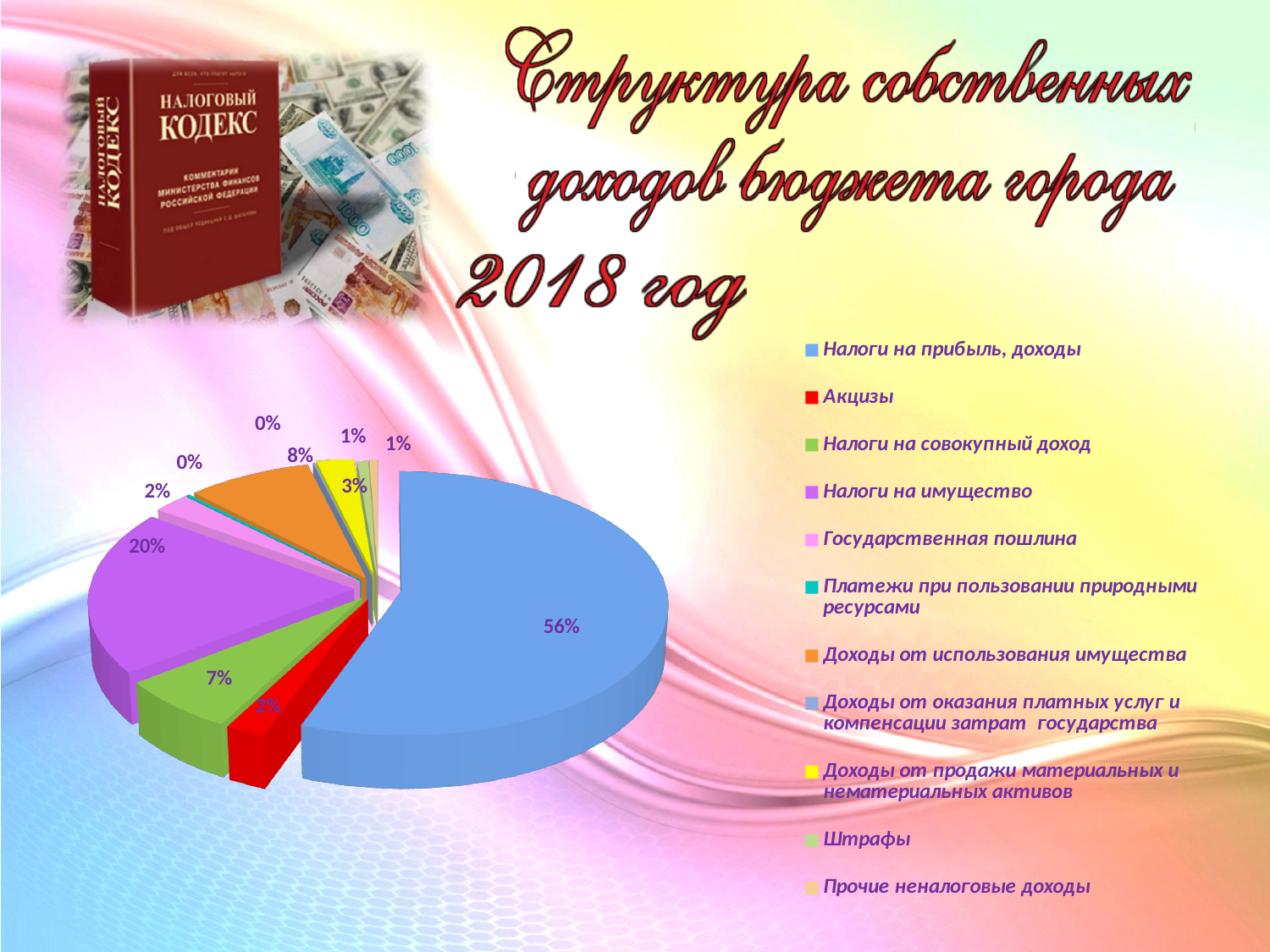
What is the difference in percentage points between the share for Налоги на прибыль, доходы and the share for Налоги на имущество? 36 Which is larger: the share for Налоги на имущество or the share for Доходы от использования имущества? Налоги на имущество What share of the pie is labelled for Акцизы? 2% How many categories does the legend list? 11 What share of the pie is labelled for Налоги на имущество? 20% Which year does the slide title say the budget revenue structure refers to? 2018 год What share of the pie is labelled for Налоги на прибыль, доходы? 56% What kind of chart is shown on the slide? pie chart What share of the pie is labelled for Доходы от использования имущества? 8% What share of the pie is labelled for Налоги на совокупный доход? 7% Which category has the largest share of the pie? Налоги на прибыль, доходы What share of the pie is labelled for Доходы от продажи материальных и нематериальных активов? 3%